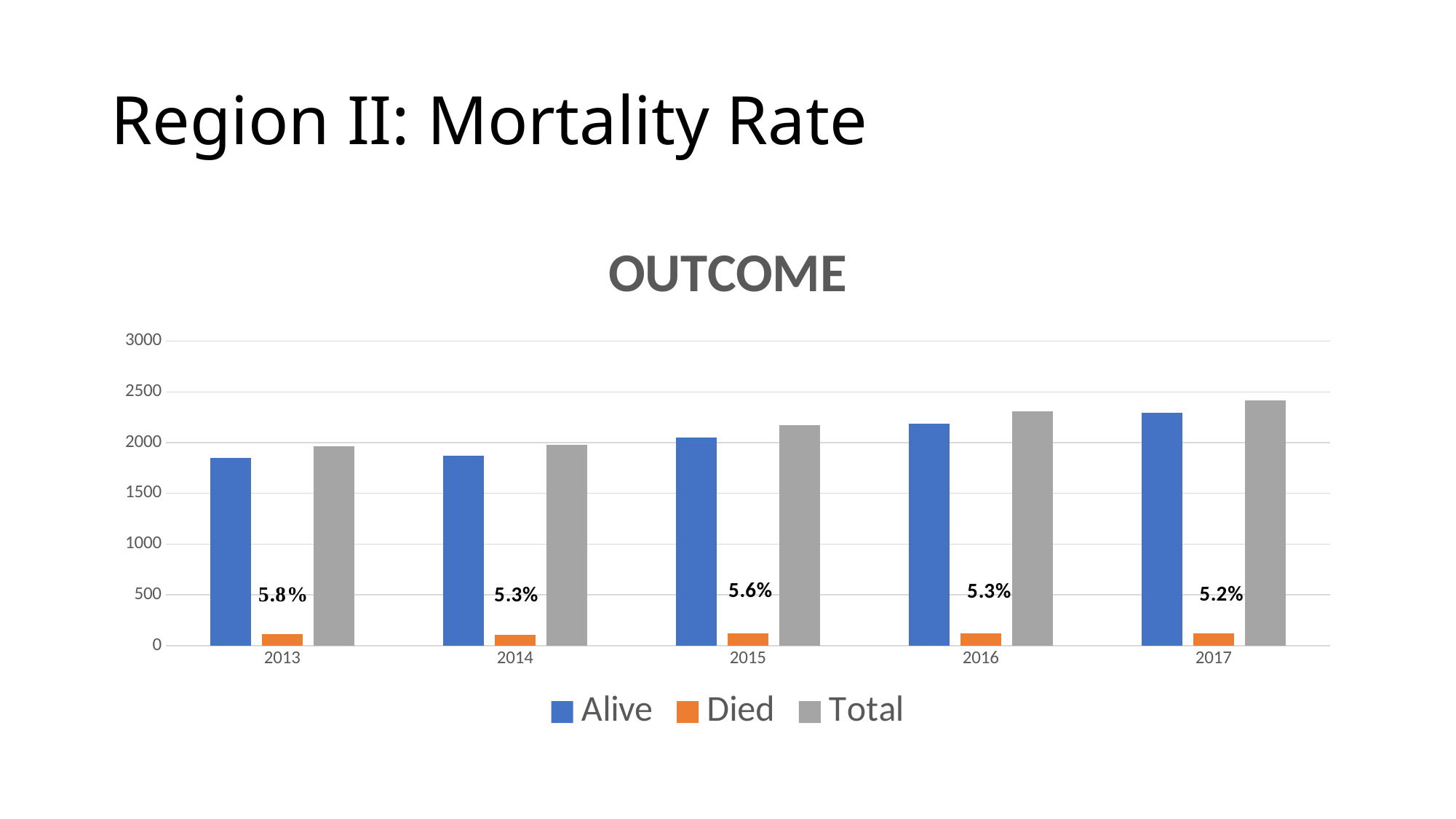
What mortality rate percentage is labelled for 2013? 5.8% Which year has the lowest labelled mortality rate percentage? 2017 Do the Total values rise or fall from 2013 to 2017? rise What kind of chart is shown on the slide? bar chart How many years are shown on the x axis? 5 What is the title of the chart? OUTCOME Which year has the highest labelled mortality rate percentage? 2013 Is the Total value for 2017 greater or less than 2000? greater What mortality rate percentage is labelled for 2017? 5.2% What is the difference between the mortality rate percentages labelled for 2013 and 2017? 0.6% How many series does the legend list? 3 Is the Alive value for 2013 greater or less than 2000? less